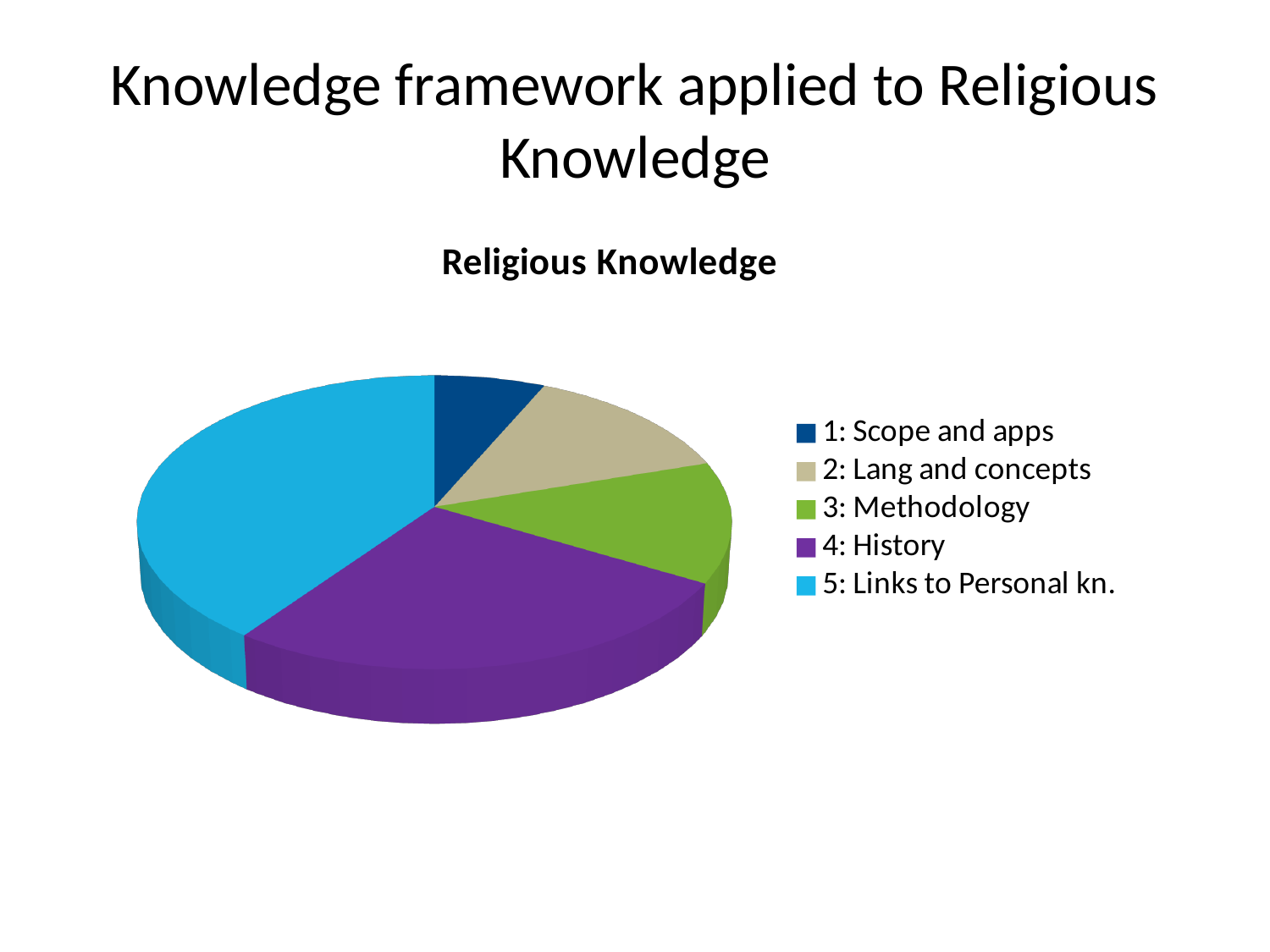
Which slice is larger, 1: Scope and apps or 2: Lang and concepts? 2: Lang and concepts Which slice is larger, 4: History or 3: Methodology? 4: History What colour is the slice for 4: History? purple How many slices does the pie chart have? 5 What kind of chart is shown on the slide? pie chart Which category has the smallest slice in the pie chart? 1: Scope and apps Which slice is larger, 5: Links to Personal kn. or 2: Lang and concepts? 5: Links to Personal kn. How many entries does the legend of the pie chart list? 5 What is the title of the pie chart? Religious Knowledge